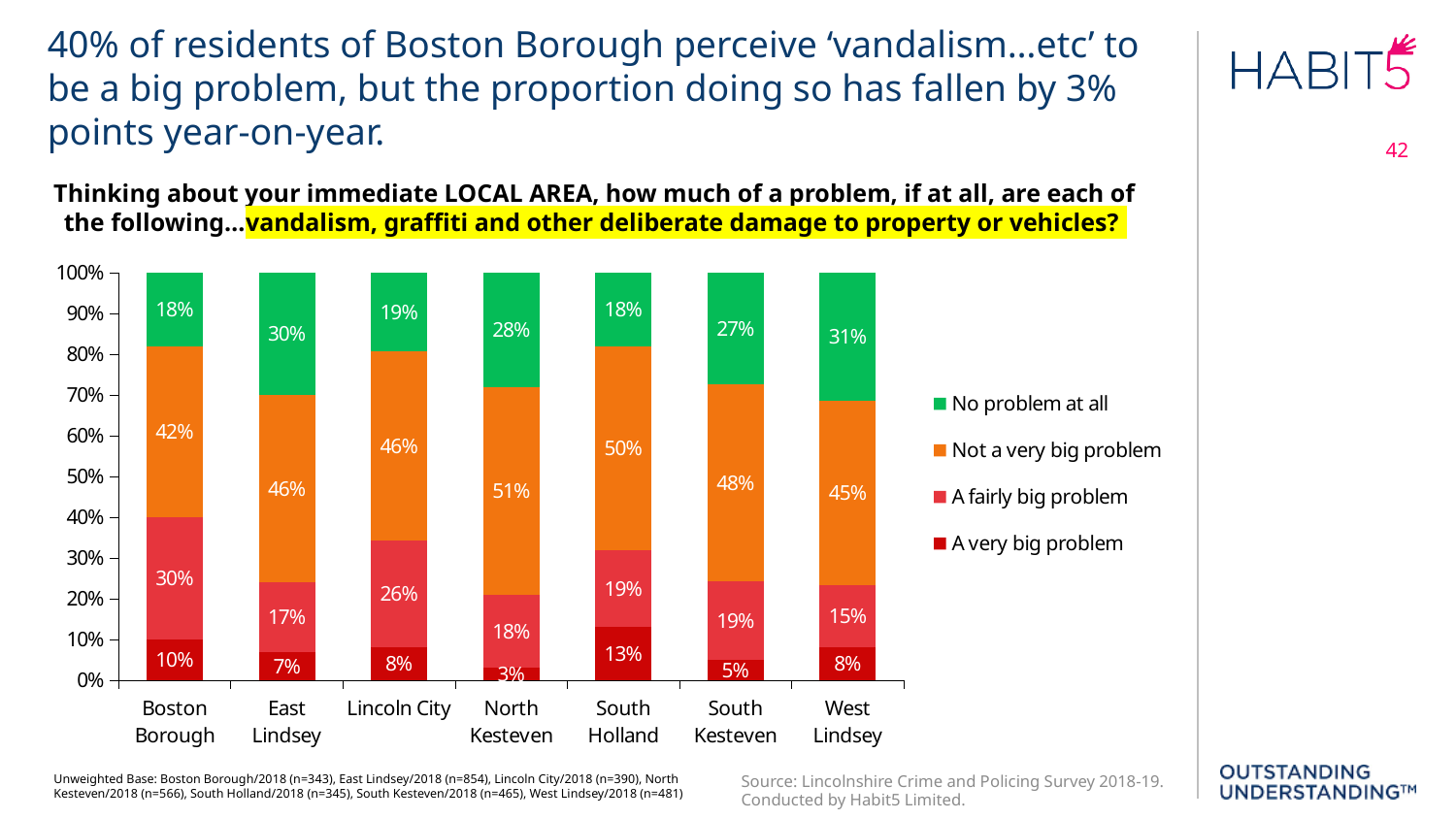
Which is larger: the 'A fairly big problem' value for South Kesteven or for West Lindsey? South Kesteven What percentage of Boston Borough residents say vandalism is 'A very big problem'? 10% How many series does the legend list? 4 What is the 'Not a very big problem' value for North Kesteven? 51% What is the 'A fairly big problem' value for Lincoln City? 26% What type of chart is shown on the slide? Stacked bar chart What is the 'No problem at all' value for West Lindsey? 31% Which area has the lowest 'A very big problem' percentage? North Kesteven Which area has the highest 'A very big problem' percentage? South Holland What is the difference between the 'No problem at all' values for East Lindsey and South Holland? 12% How many areas are shown on the x axis of the chart? 7 Which area has the highest 'A fairly big problem' percentage? Boston Borough